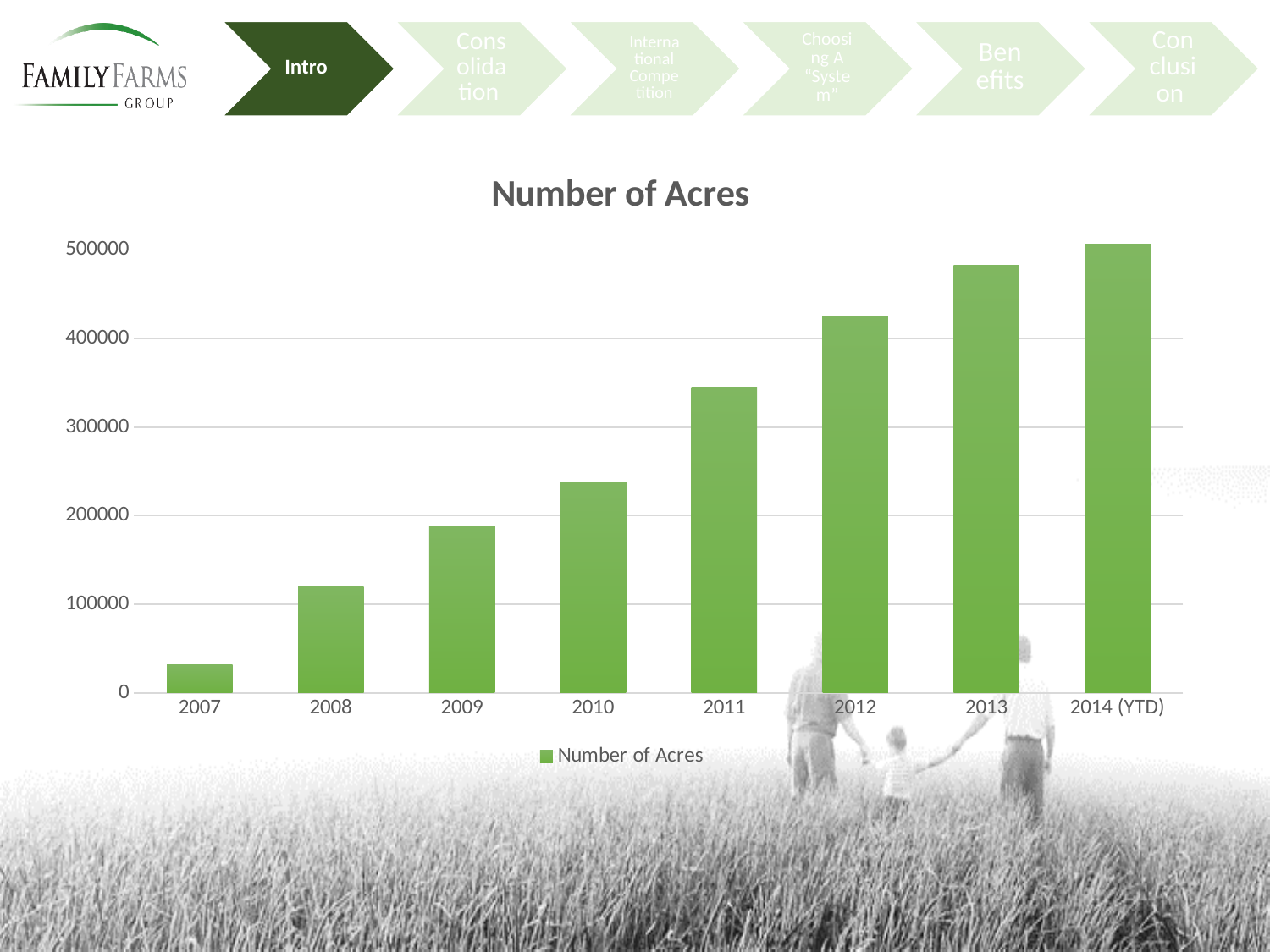
Is the value for 2010 greater or less than 200000? greater Which year has the highest number of acres? 2014 (YTD) Is the value for 2007 greater or less than 100000? less Do the values rise or fall from 2007 to 2014 (YTD)? rise Which is larger, the value for 2009 or the value for 2011? 2011 How many series does the chart's legend list? 1 How many years (categories) are shown on the x axis of the chart? 8 Is the value for 2013 greater or less than 500000? less What is the title of the chart? Number of Acres What kind of chart is shown on the slide? bar chart Which year has the lowest number of acres? 2007